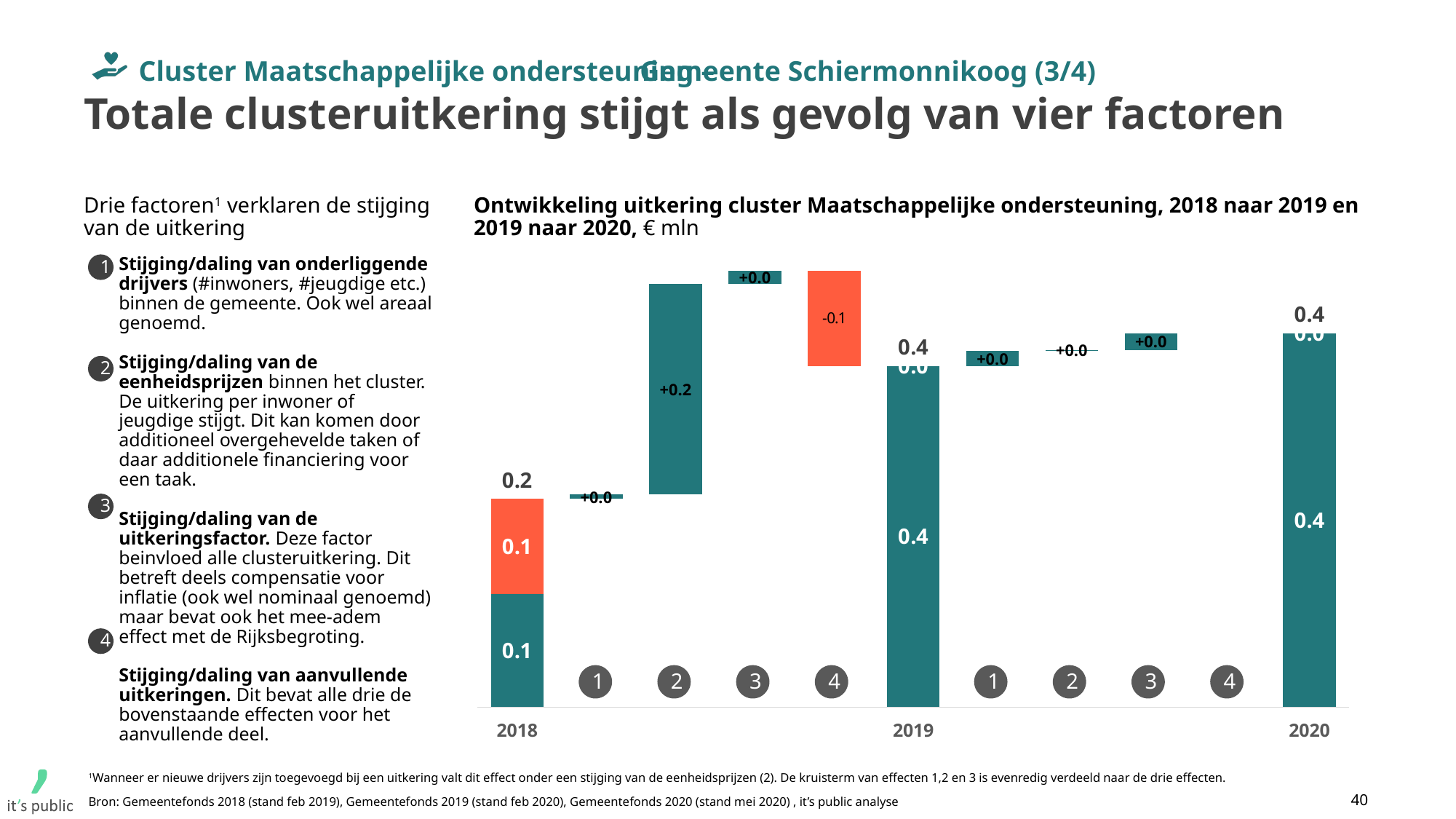
What kind of chart is shown on the slide? Bar chart (waterfall) By how much does the total increase from 2018 to 2019? 0.2 Which factor contributes the largest increase between 2018 and 2019? Factor 2 Which year has the larger total, 2018 or 2019? 2019 Which factor has the lowest (most negative) change between 2018 and 2019? Factor 4 How many year totals (2018, 2019, 2020) are shown on the chart? 3 What is the total cluster payment shown for 2018? 0.2 What is the total cluster payment shown for 2019? 0.4 What is the change attributed to factor 2 between 2018 and 2019? +0.2 What is the change attributed to factor 1 between 2019 and 2020? +0.0 What is the total cluster payment shown for 2020? 0.4 What is the change attributed to factor 4 between 2018 and 2019? -0.1